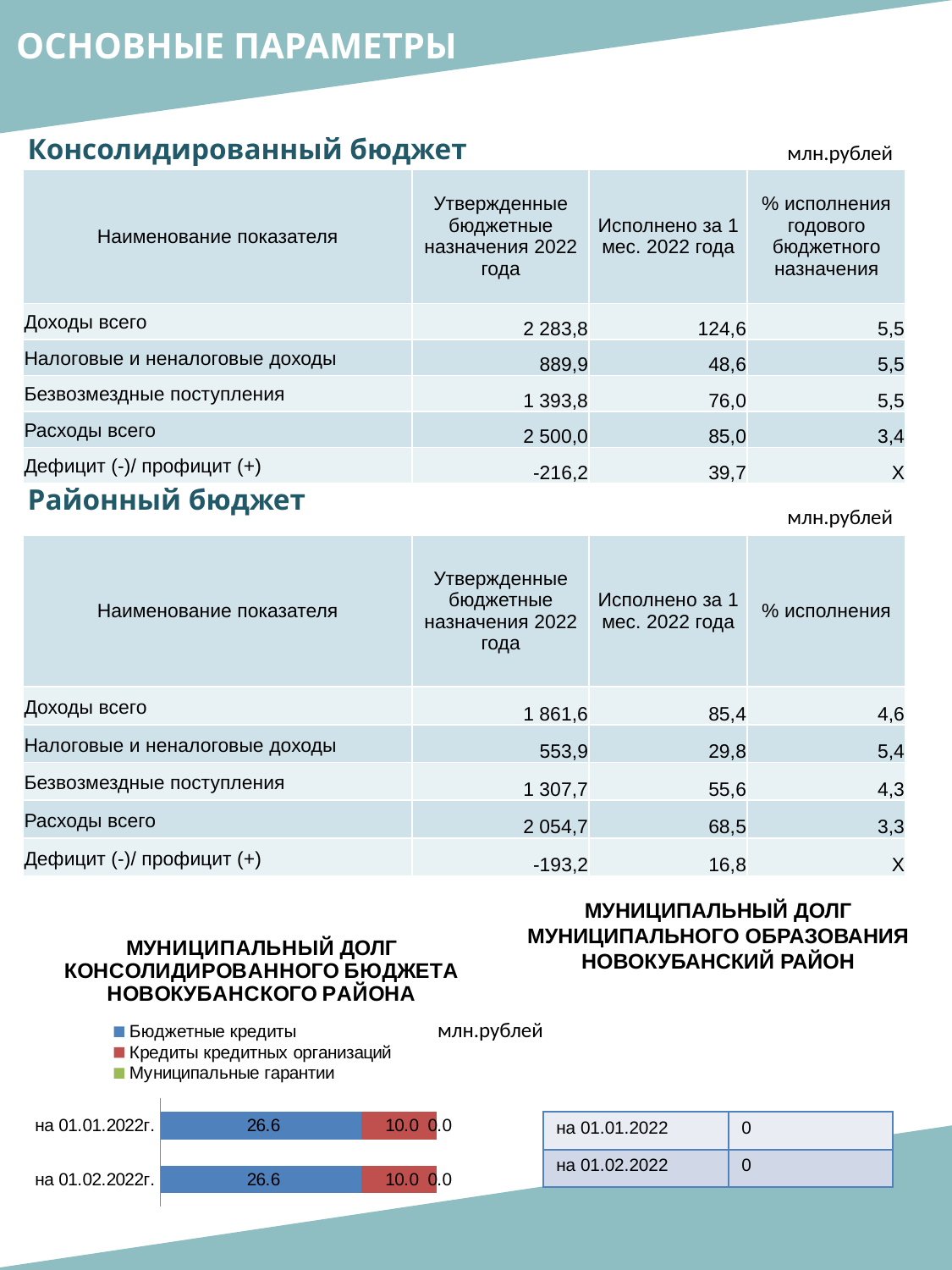
In the municipal debt chart, what is the value of 'Бюджетные кредиты' for 'на 01.01.2022г.'? 26.6 In the municipal debt chart, what is the difference between 'Бюджетные кредиты' and 'Кредиты кредитных организаций' for 'на 01.01.2022г.'? 16.6 In the municipal debt chart, what is the value of 'Кредиты кредитных организаций' for 'на 01.02.2022г.'? 10.0 How many categories (dates) are shown on the municipal debt chart? 2 In the municipal debt chart, which series has the largest value for 'на 01.02.2022г.'? Бюджетные кредиты What kind of chart is shown under the title 'МУНИЦИПАЛЬНЫЙ ДОЛГ КОНСОЛИДИРОВАННОГО БЮДЖЕТА НОВОКУБАНСКОГО РАЙОНА'? bar chart How many series does the legend of the municipal debt chart list? 3 In the municipal debt chart, which series has the smallest value for 'на 01.01.2022г.'? Муниципальные гарантии In the municipal debt chart, what is the total of the stacked bar for 'на 01.02.2022г.'? 36.6 In the municipal debt chart, is 'Бюджетные кредиты' larger for 'на 01.01.2022г.' or for 'на 01.02.2022г.'? They are equal (26.6) In the municipal debt chart, what is the value of 'Муниципальные гарантии' for 'на 01.01.2022г.'? 0.0 In the municipal debt chart, what unit is stated next to the legend? млн.рублей